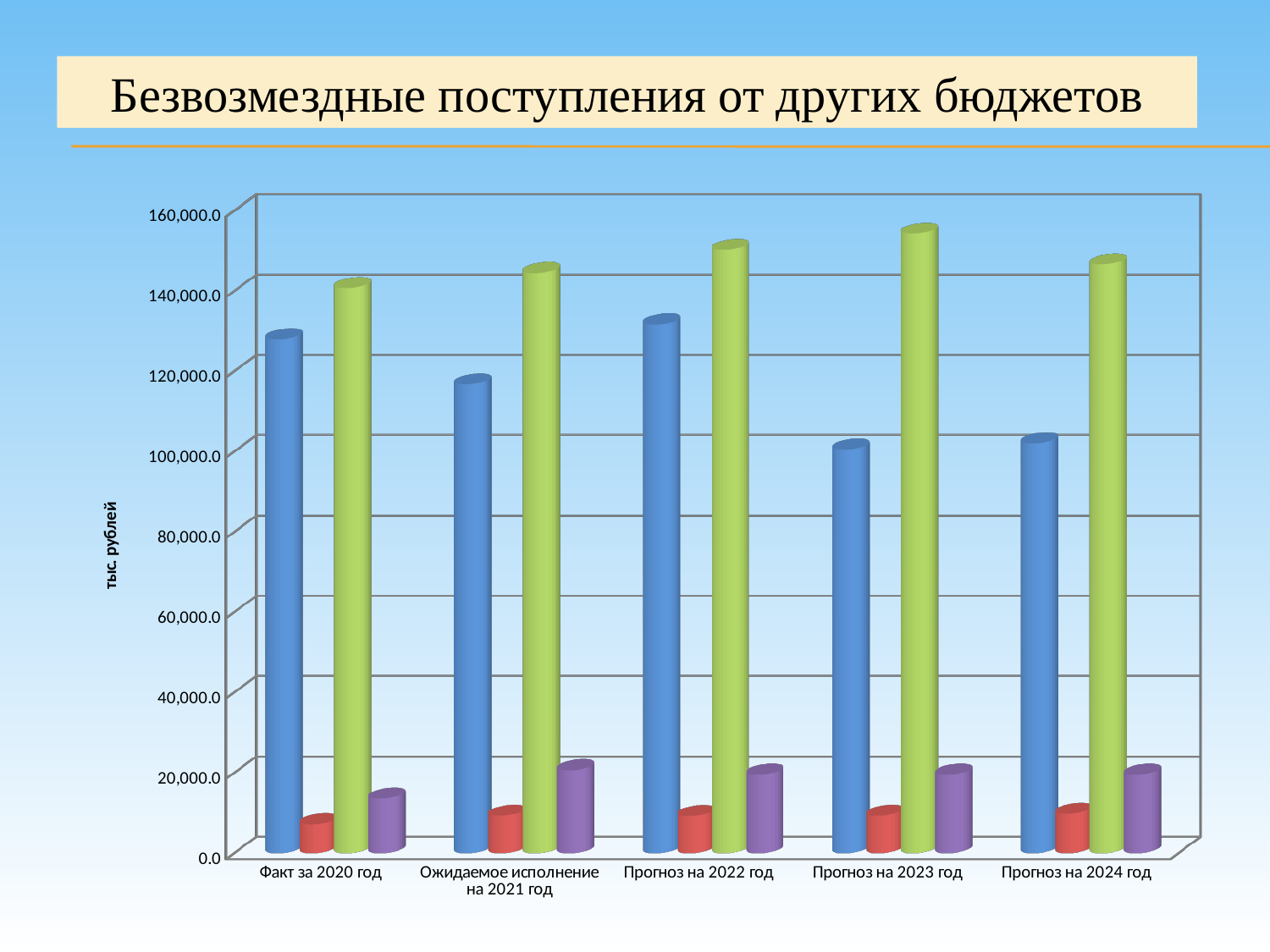
For Прогноз на 2024 год, which is larger: the blue bar or the green bar? the green bar How many categories are shown along the x axis? 5 Is the value of the blue bar for Ожидаемое исполнение на 2021 год greater or less than 120,000.0? less In which category is the blue bar the highest? Прогноз на 2022 год What is the title of the chart? Безвозмездные поступления от других бюджетов Is the value of the red bar for Прогноз на 2022 год greater or less than 20,000.0? less In which category is the green bar the highest? Прогноз на 2023 год What unit is shown on the vertical axis label? тыс. рублей Is the value of the blue bar for Факт за 2020 год greater or less than 120,000.0? greater What kind of chart is shown on the slide? bar chart In which category is the purple bar the lowest? Факт за 2020 год